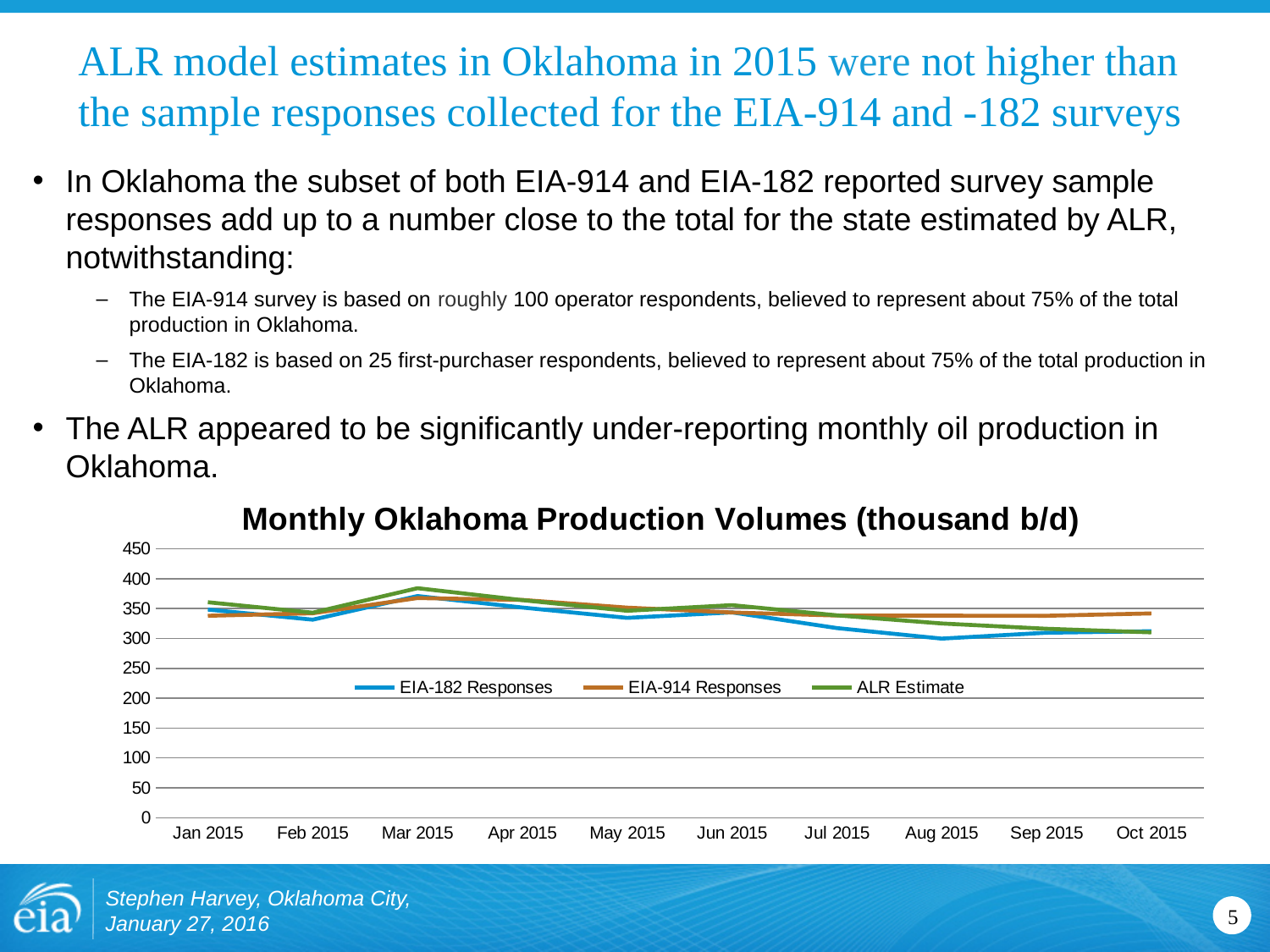
Is the ALR Estimate value for Mar 2015 greater or less than 350? greater Does the ALR Estimate rise or fall from Mar 2015 to Oct 2015? fall What kind of chart is shown on the slide? line chart In which month does the ALR Estimate reach its highest value? Mar 2015 Is the EIA-182 Responses value for Aug 2015 greater or less than 350? less Which series in the chart is drawn in green? ALR Estimate How many months are plotted along the x axis of the chart? 10 In which month is the EIA-182 Responses value lowest? Aug 2015 In Aug 2015, which is larger: EIA-914 Responses or EIA-182 Responses? EIA-914 Responses Is the EIA-914 Responses value for Jan 2015 greater or less than 300? greater How many series does the legend of the chart list? 3 What is the title of the chart? Monthly Oklahoma Production Volumes (thousand b/d)